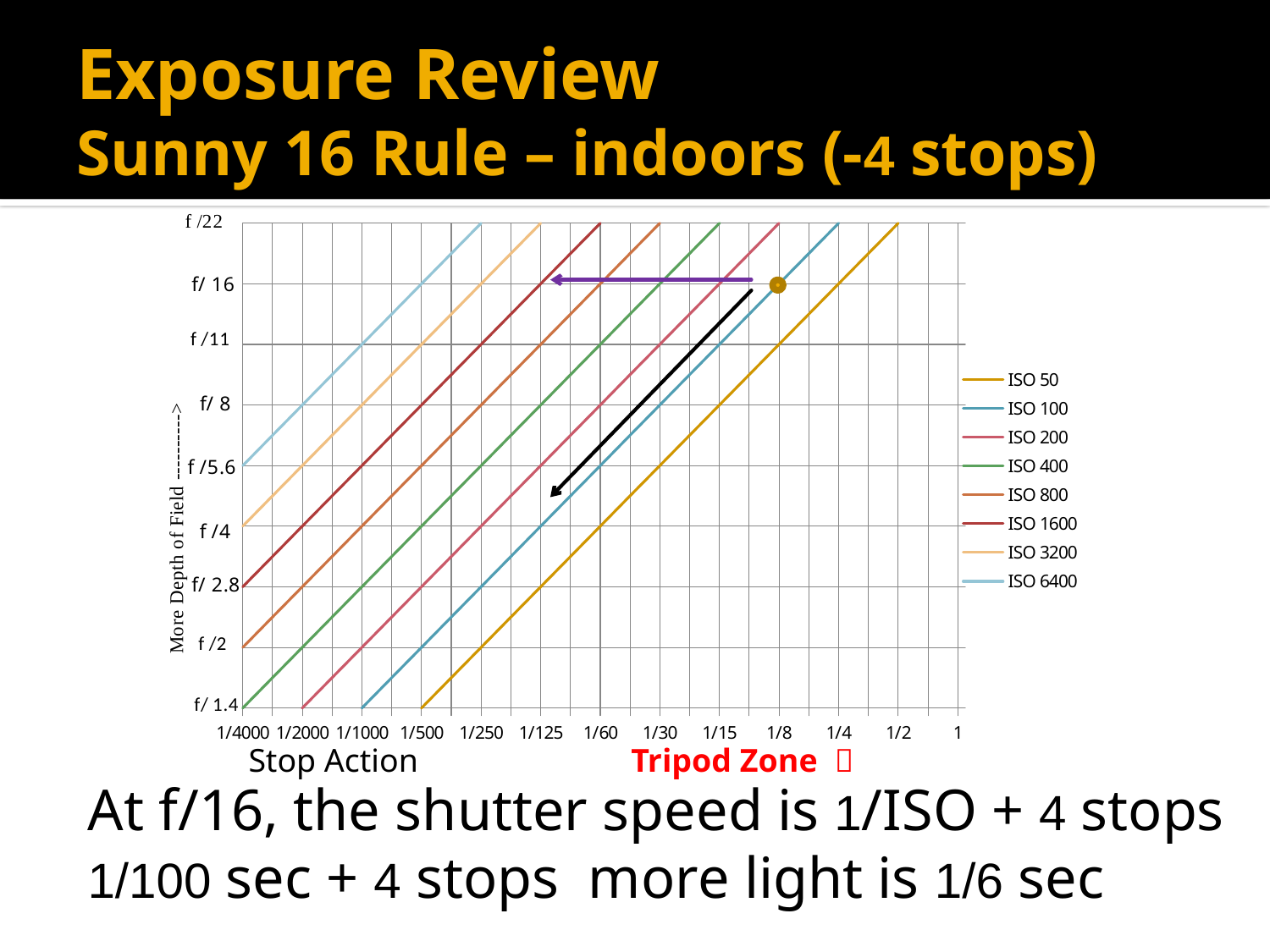
How many series does the chart's legend list? 8 What is the leftmost shutter-speed label on the chart's x axis? 1/4000 What is the topmost f-stop label on the chart's y axis? f /22 Do the ISO lines rise or fall as the shutter speed moves from 1/4000 toward 1 along the x axis? rise What is the lowest f-stop label on the chart's y axis? f/ 1.4 Which ISO series is listed first in the chart's legend? ISO 50 How many f-stop tick labels are shown along the y axis of the chart? 9 What is the rightmost shutter-speed label on the chart's x axis? 1 What kind of chart is shown on the slide? line chart Which ISO series is listed last in the chart's legend? ISO 6400 Which ISO series line lies furthest to the right on the chart? ISO 50 How many shutter-speed tick labels are shown along the x axis of the chart? 13